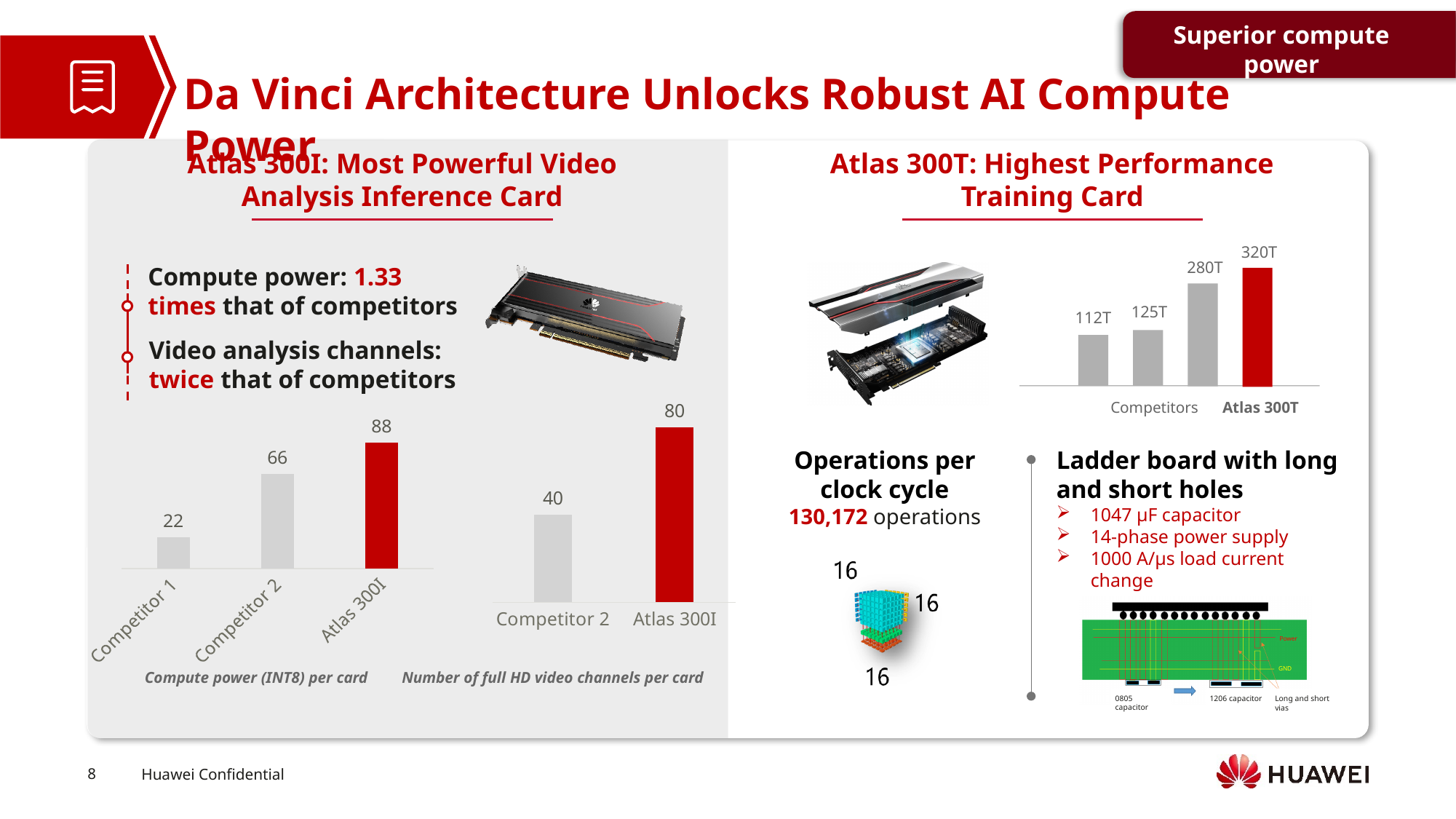
What type of chart is the 'Compute power (INT8) per card' chart? Bar chart In the Atlas 300T chart on the right, which bar has the highest value? Atlas 300T In the 'Number of full HD video channels per card' chart, which is larger, Atlas 300I or Competitor 2? Atlas 300I In the Atlas 300T chart on the right, what is the value for Atlas 300T? 320T How many bars are shown in the Atlas 300T chart on the right? 4 In the 'Compute power (INT8) per card' chart, which category has the lowest value? Competitor 1 In the 'Number of full HD video channels per card' chart, what is the difference between Atlas 300I and Competitor 2? 40 How many categories are shown in the 'Compute power (INT8) per card' chart? 3 In the 'Compute power (INT8) per card' chart, what is the value for Atlas 300I? 88 In the 'Compute power (INT8) per card' chart, what is the value for Competitor 1? 22 In the 'Number of full HD video channels per card' chart, what is the value for Competitor 2? 40 In the 'Compute power (INT8) per card' chart, what is the difference between Atlas 300I and Competitor 2? 22